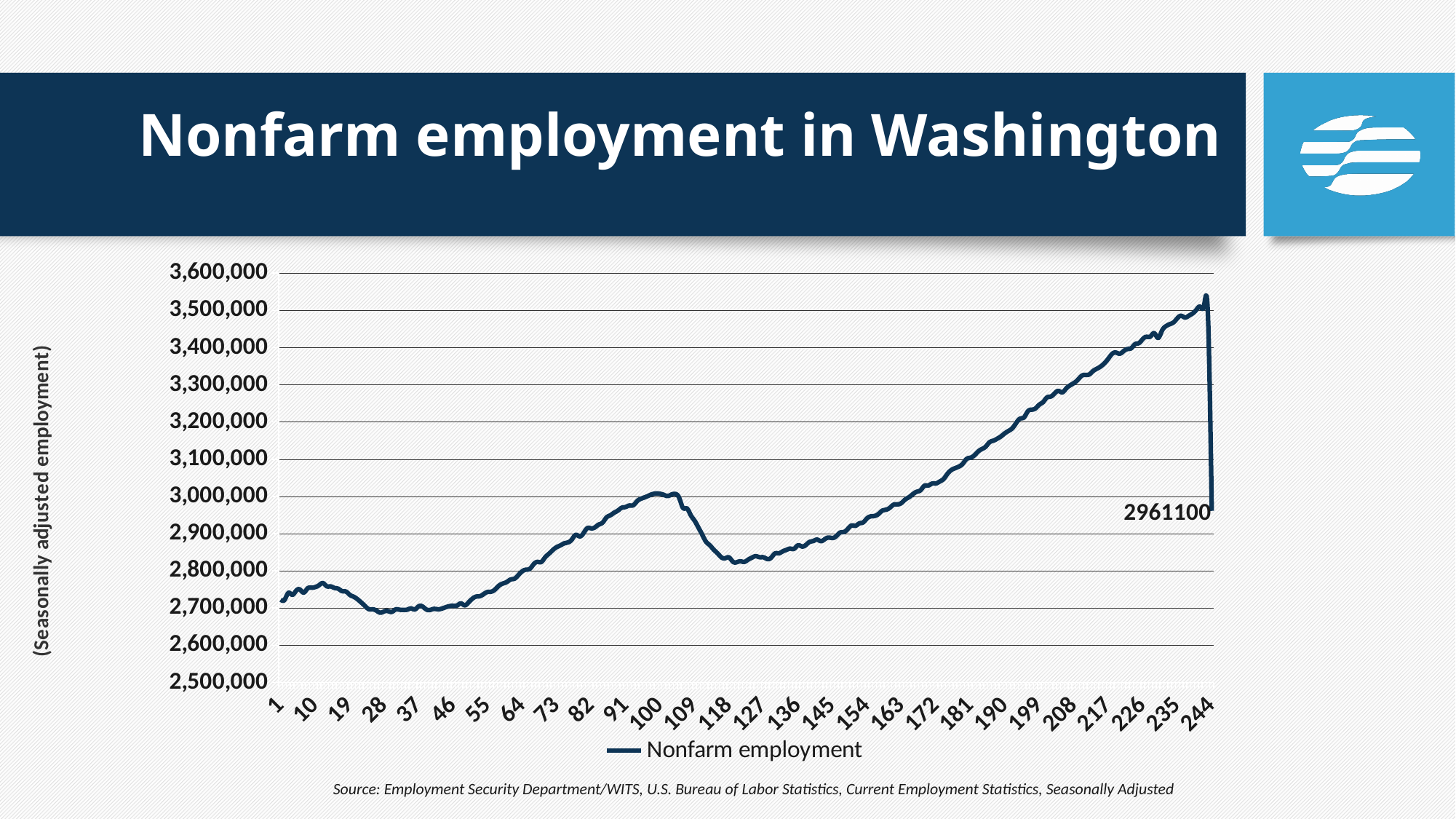
Is the value for Nonfarm employment at point 1 greater or less than 2,800,000? less Is the value for Nonfarm employment at point 235 greater or less than 3,400,000? greater How many series does the legend list? 1 Which is larger: the Nonfarm employment value at point 100 or at point 28? point 100 Between points 136 and 226, does the Nonfarm employment line rise or fall? rise Between points 109 and 118, does the Nonfarm employment line rise or fall? fall What kind of chart is shown on the slide? line chart What is the name of the series shown in the legend? Nonfarm employment What value is printed as the data label at the final point of the line? 2961100 What is the label on the vertical axis of the chart? (Seasonally adjusted employment) Is the value for Nonfarm employment at point 127 greater or less than 2,900,000? less